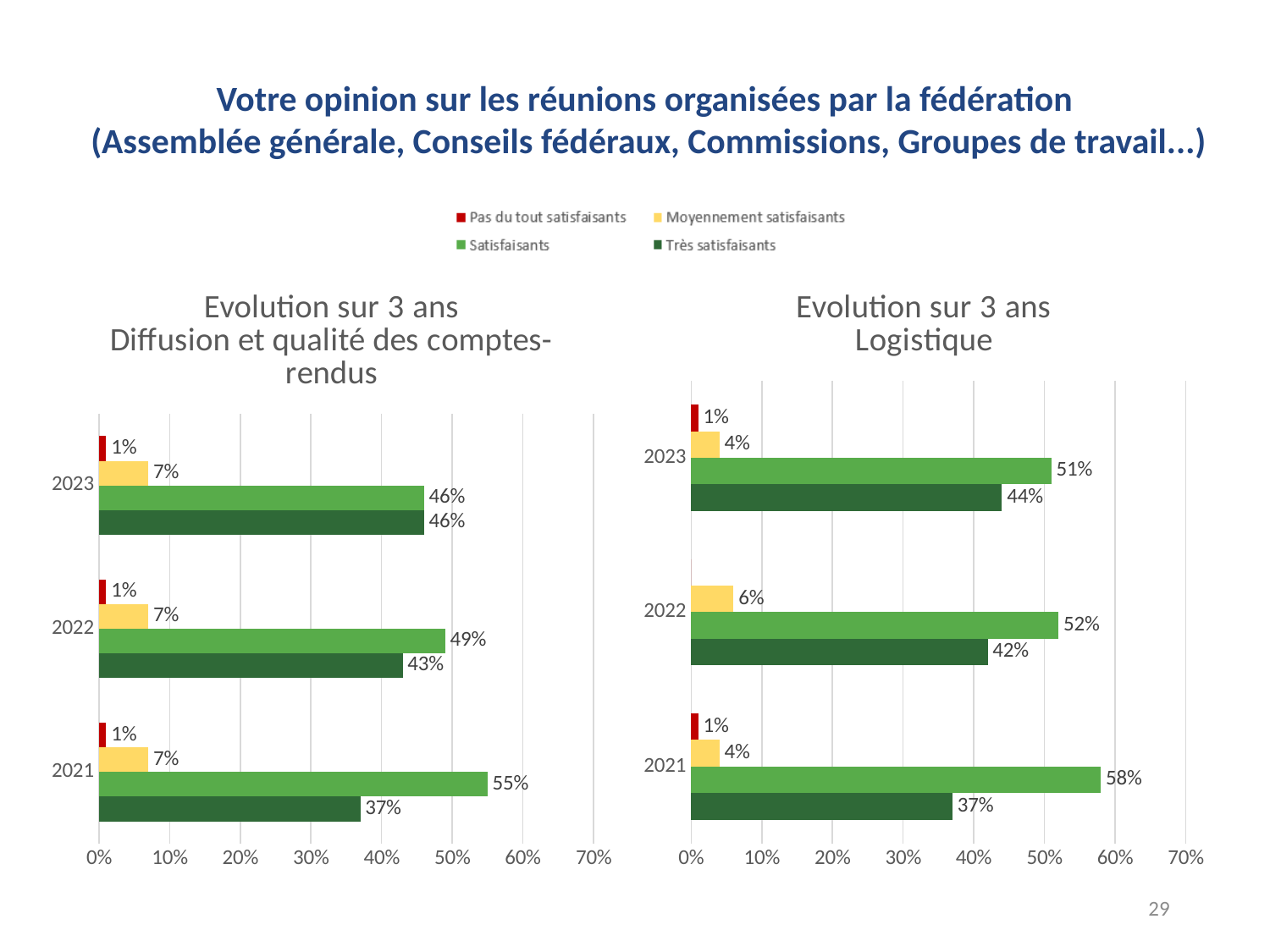
In the 'Evolution sur 3 ans Diffusion et qualité des comptes-rendus' chart, does the 'Très satisfaisants' value rise or fall from 2021 to 2023? Rise How many series does the legend list for the charts on this slide? 4 In the 'Evolution sur 3 ans Logistique' chart, what is the value for 'Satisfaisants' in 2021? 58% What type of chart is the 'Evolution sur 3 ans Logistique' chart? Bar chart How many years are shown on the y axis of the 'Evolution sur 3 ans Diffusion et qualité des comptes-rendus' chart? 3 In the 'Evolution sur 3 ans Diffusion et qualité des comptes-rendus' chart, which year has the highest value for 'Satisfaisants'? 2021 In the 'Evolution sur 3 ans Logistique' chart, is the value for 'Satisfaisants' in 2022 greater or less than 50%? greater In the 'Evolution sur 3 ans Logistique' chart, which year has the lowest value for 'Très satisfaisants'? 2021 In the 'Evolution sur 3 ans Logistique' chart, what is the value for 'Moyennement satisfaisants' in 2022? 6% In the 'Evolution sur 3 ans Diffusion et qualité des comptes-rendus' chart, what is the value for 'Très satisfaisants' in 2022? 43% In the 'Evolution sur 3 ans Diffusion et qualité des comptes-rendus' chart, what is the difference between the 'Satisfaisants' values for 2021 and 2023? 9% In the 'Evolution sur 3 ans Logistique' chart, which is larger in 2023: 'Satisfaisants' or 'Très satisfaisants'? Satisfaisants